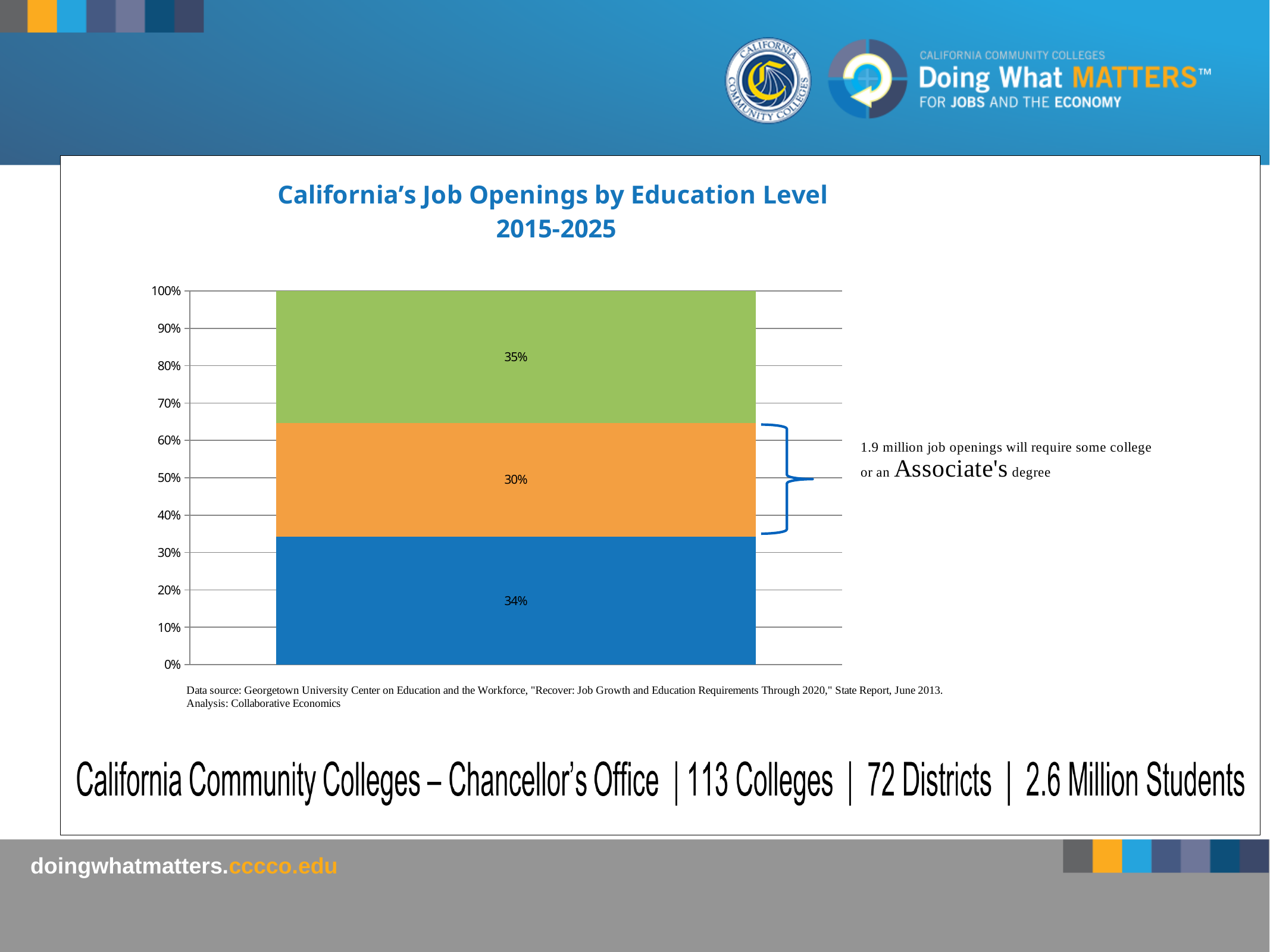
Which segment of the bar has the smallest value? the orange (middle) segment, 30% What value is labelled on the green (top) segment of the bar? 35% What kind of chart is shown on the slide? stacked bar chart What is the title of the chart? California's Job Openings by Education Level 2015-2025 Which is larger, the blue segment's value or the orange segment's value? the blue segment (34%) According to the annotation next to the orange segment, how many job openings will require some college or an Associate's degree? 1.9 million What is the difference between the green segment's value and the orange segment's value? 5% What value is labelled on the blue (bottom) segment of the bar? 34% Which segment of the bar has the largest value? the green (top) segment, 35% What is the total of the three segments in the stacked bar? 99% How many segments make up the stacked bar? 3 What value is labelled on the orange (middle) segment of the bar? 30%